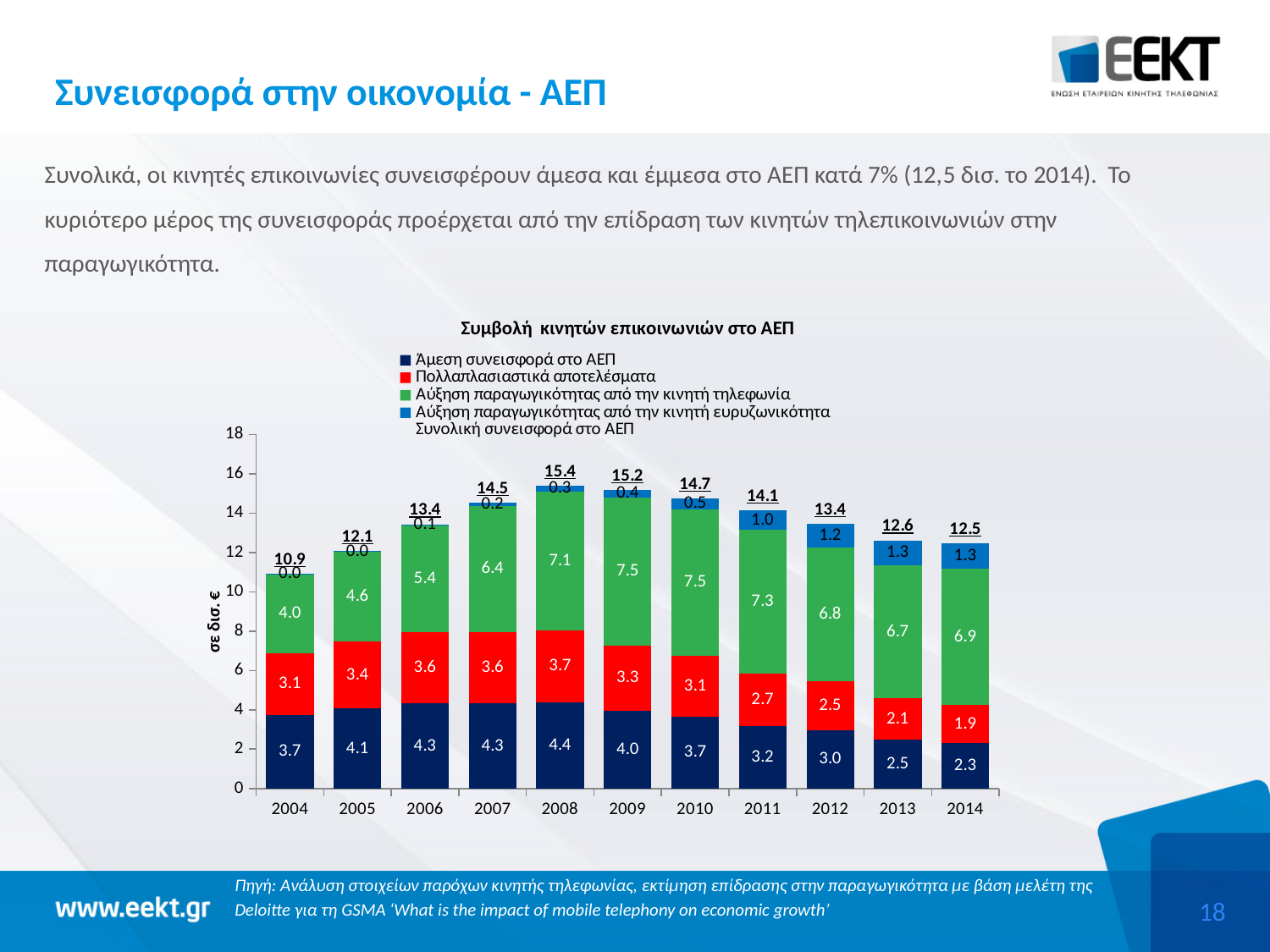
What is the difference between the total contribution in 2008 and in 2014? 2.9 Which year has the highest total contribution to GDP? 2008 How many entries does the legend list? 5 What is the value of Αύξηση παραγωγικότητας από την κινητή ευρυζωνικότητα for 2011? 1.0 What is the value of Άμεση συνεισφορά στο ΑΕΠ for 2014? 2.3 What is the total contribution to GDP (Συνολική συνεισφορά στο ΑΕΠ) shown for 2008? 15.4 Which year has the lowest total contribution to GDP? 2004 What is the title of the chart? Συμβολή κινητών επικοινωνιών στο ΑΕΠ Is the Πολλαπλασιαστικά αποτελέσματα value larger in 2008 or in 2012? 2008 What type of chart is shown on the slide? Stacked bar chart How many years are shown on the x axis? 11 How does the Άμεση συνεισφορά στο ΑΕΠ value change from 2008 to 2014? It falls